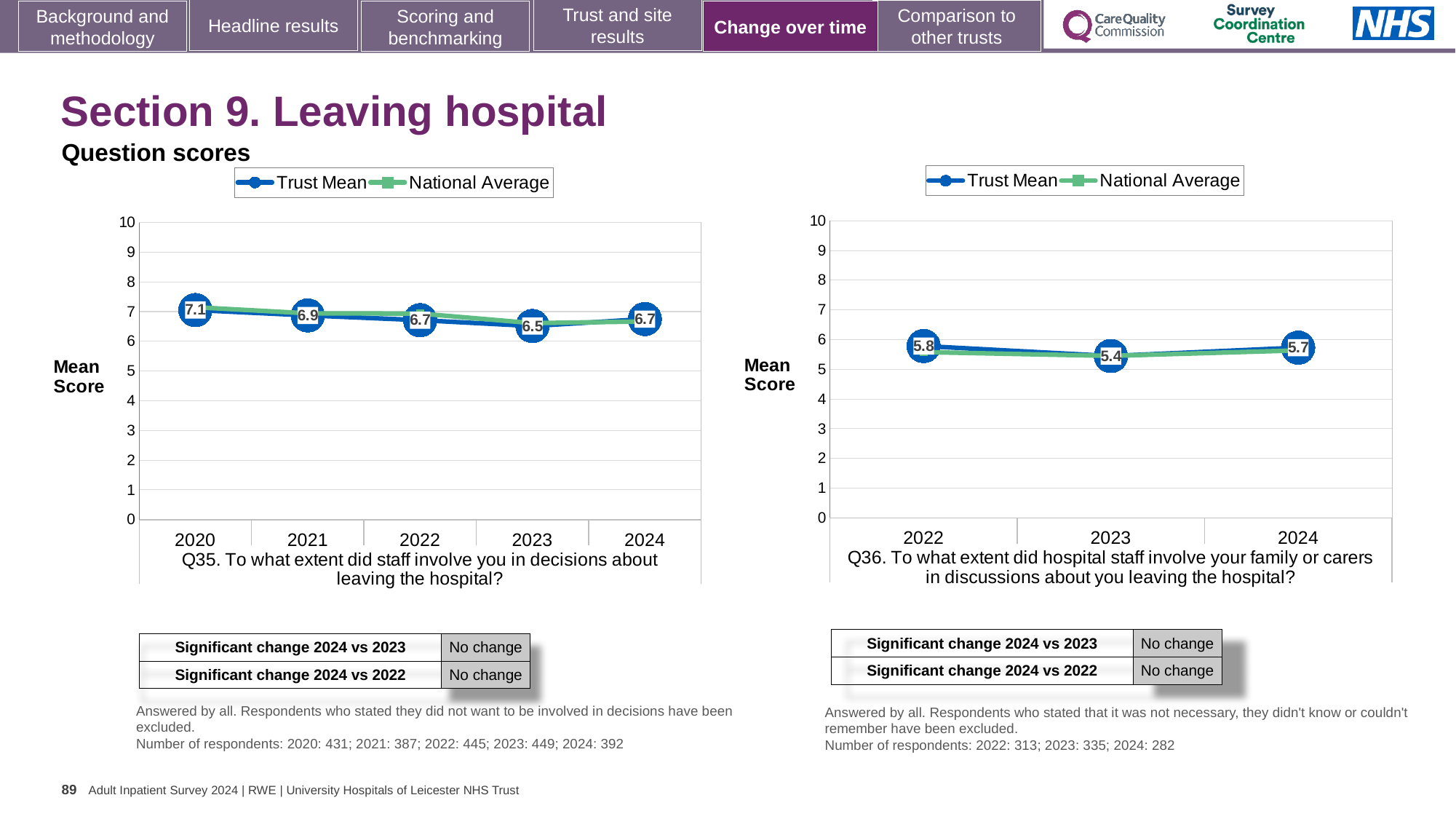
In the left chart (Q35), what is the Trust Mean score for 2020? 7.1 How many years are plotted on the x axis of the left chart (Q35)? 5 In the right chart (Q36), what is the Trust Mean score for 2024? 5.7 In the left chart (Q35), is the Trust Mean score for 2021 higher or lower than for 2024? higher In the right chart (Q36), which year has the lowest Trust Mean score? 2023 In the left chart (Q35), what is the Trust Mean score for 2023? 6.5 In the right chart (Q36), what is the difference between the Trust Mean scores for 2022 and 2023? 0.4 How many series does the legend of the right chart (Q36) list? 2 In the left chart (Q35), what is the difference between the Trust Mean scores for 2020 and 2023? 0.6 How many years are plotted on the x axis of the right chart (Q36)? 3 In the left chart (Q35), which year has the highest Trust Mean score? 2020 What type of chart is the left chart (Q35)? Line chart